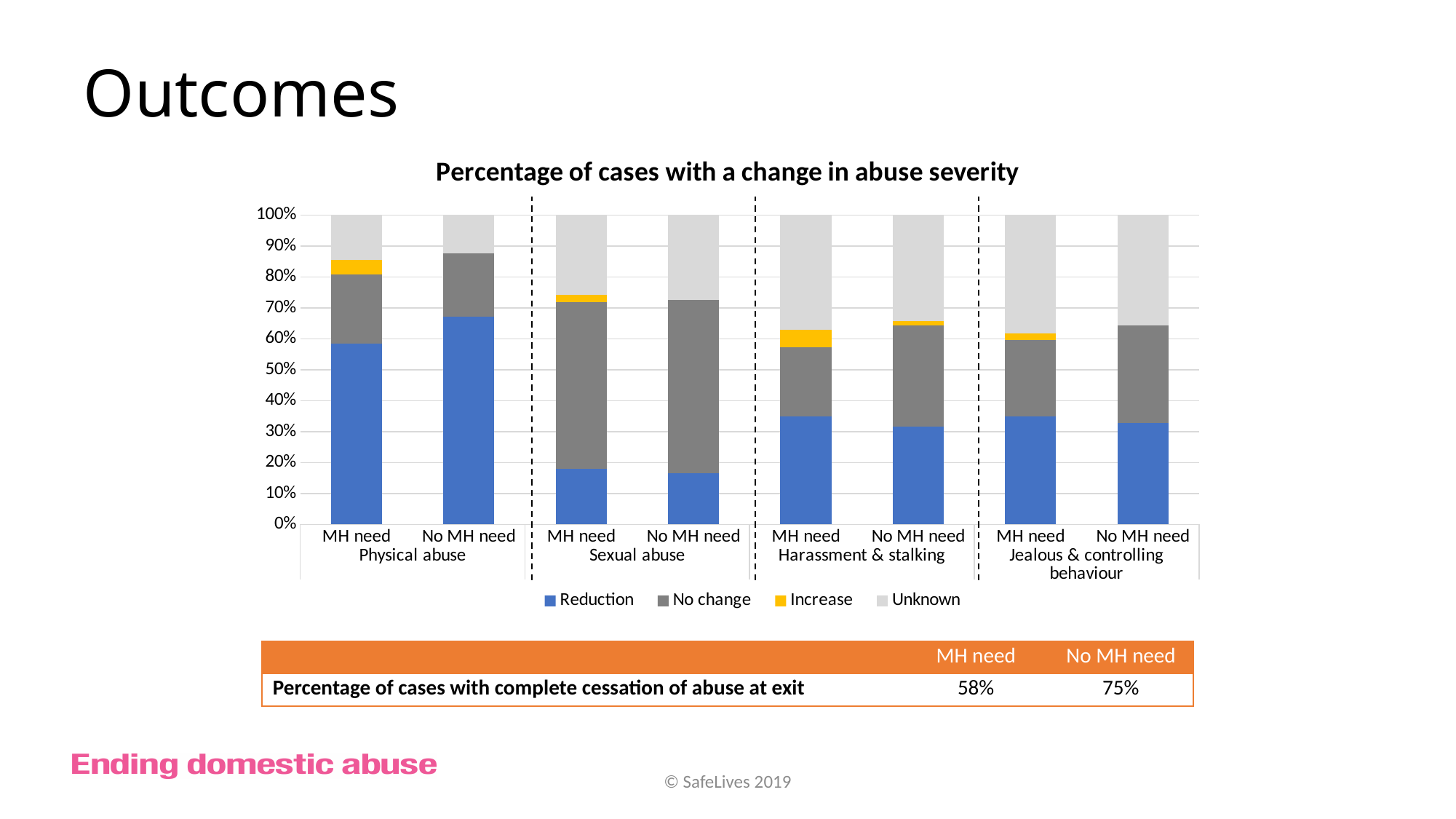
Is the Reduction value for No MH need under Harassment & stalking greater or less than 40%? less How many bars are plotted in the chart? 8 Is the Reduction value for No MH need under Physical abuse greater or less than 60%? greater Which bar has the largest Reduction segment? No MH need, Physical abuse Which colour represents the Increase series in the chart? Yellow What kind of chart is shown on the slide? Stacked bar chart How many series does the chart legend list? 4 What is the title of the chart? Percentage of cases with a change in abuse severity Is the Reduction value for MH need under Sexual abuse greater or less than 30%? less Under Physical abuse, which group has the larger Reduction segment, MH need or No MH need? No MH need Which abuse type shows the largest Reduction segments for both MH need and No MH need? Physical abuse